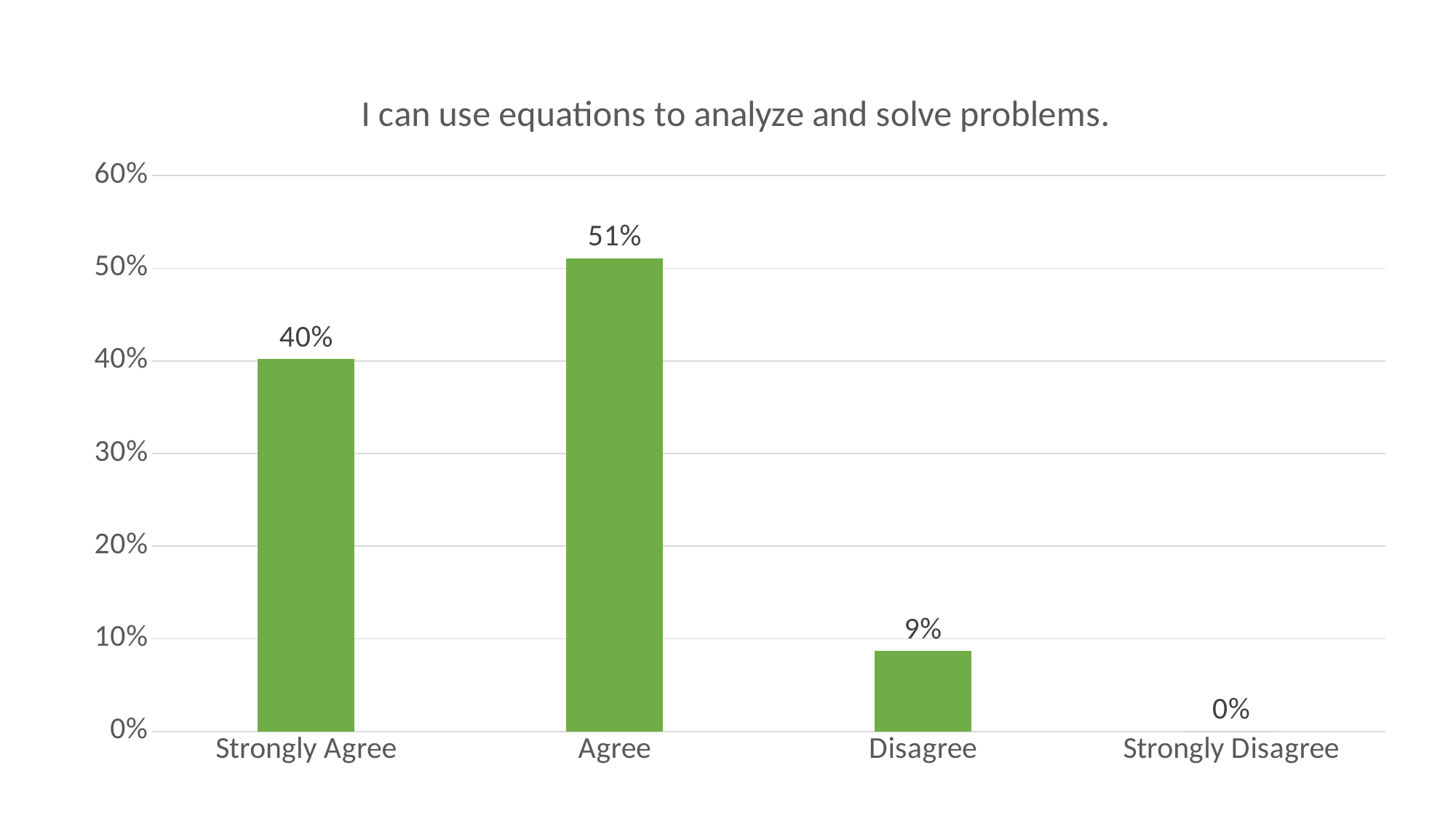
What is the title of the chart? I can use equations to analyze and solve problems. What kind of chart is shown on the slide? Bar chart What is the value for Strongly Agree? 40% Which response category has the lowest value? Strongly Disagree What percentage of respondents chose Disagree? 9% Which is larger, the value for Strongly Agree or the value for Disagree? Strongly Agree What is the difference between the Agree and Strongly Agree values? 11% Which response category has the highest value? Agree What percentage of respondents chose Agree? 51% How many response categories are shown on the x axis? 4 Is the value for Agree greater or less than 50%? greater What is the value for Strongly Disagree? 0%